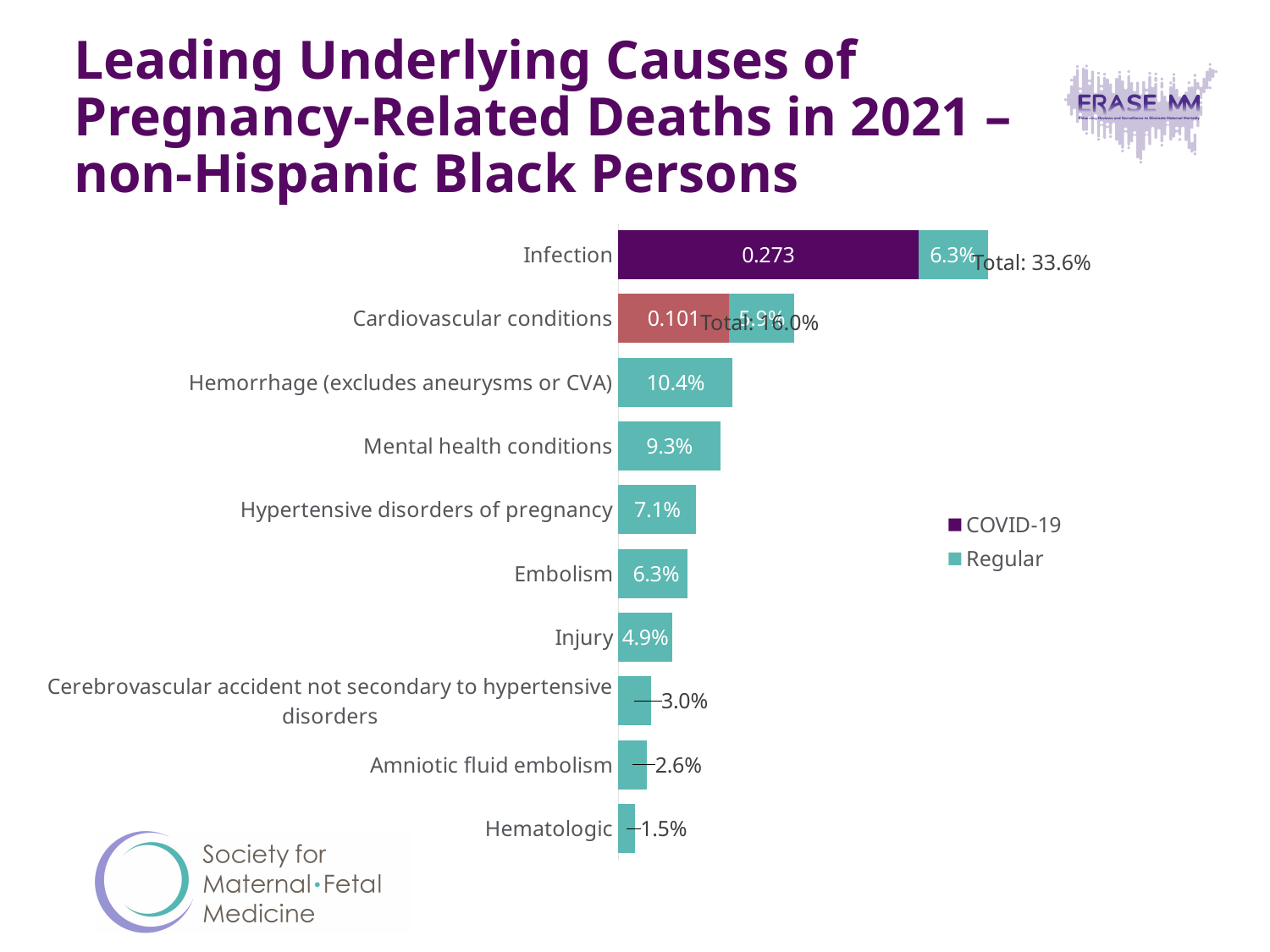
What is the Regular value for Infection? 6.3% What kind of chart is shown on the slide? bar chart What is the total shown for Cardiovascular conditions? 16.0% How many series does the legend list? 2 What is the value for Hemorrhage (excludes aneurysms or CVA)? 10.4% Which cause has the lowest value? Hematologic What is the total shown for Infection? 33.6% How many causes of death are listed on the chart? 10 What is the value for Hematologic? 1.5% Which is larger, the value for Embolism or the value for Injury? Embolism What is the difference between the values for Hemorrhage (excludes aneurysms or CVA) and Mental health conditions? 1.1% What is the value for Mental health conditions? 9.3%